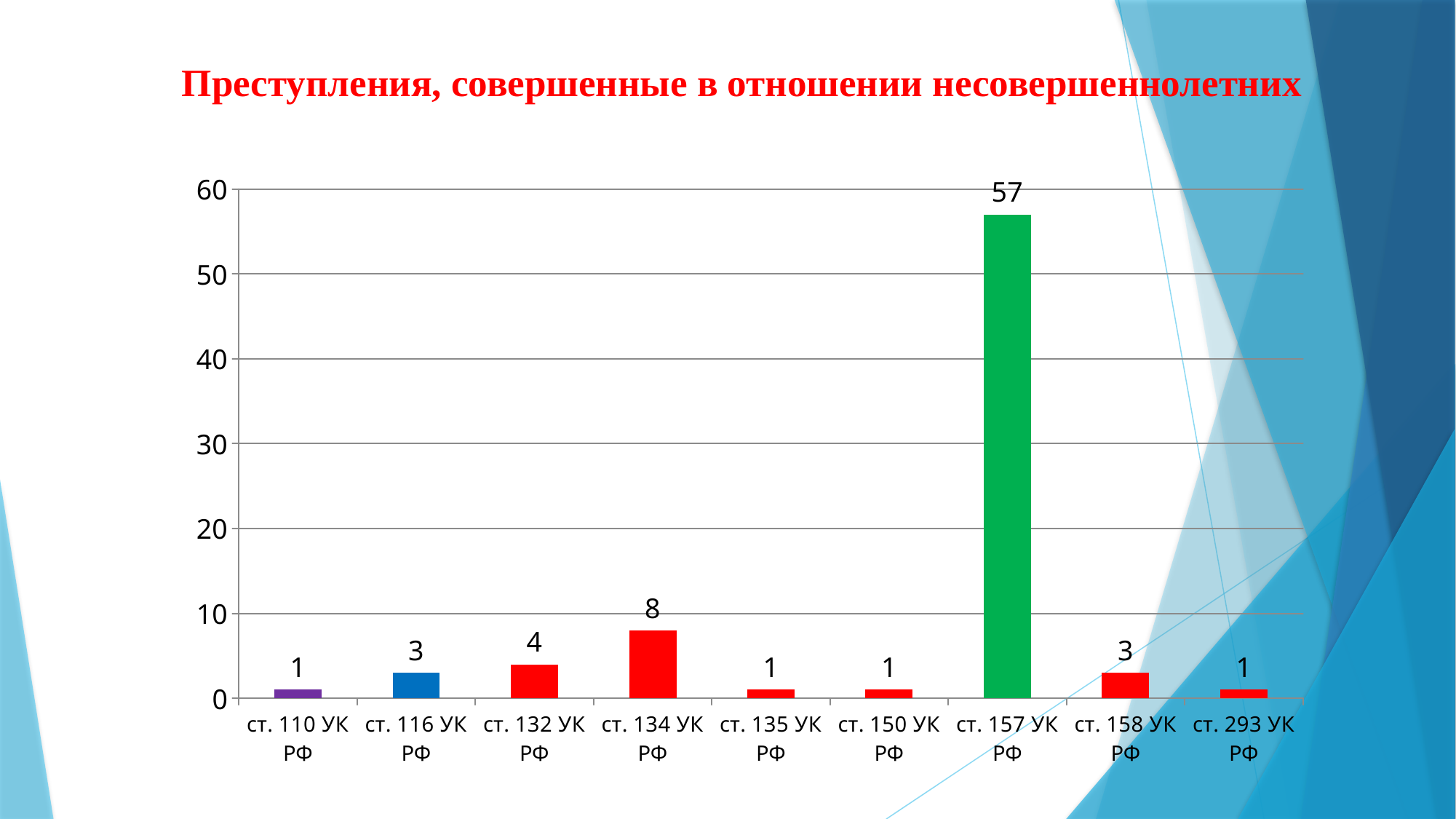
What colour is the bar for ст. 157 УК РФ? green What is the value for ст. 134 УК РФ? 8 What is the difference between the values for ст. 157 УК РФ and ст. 134 УК РФ? 49 Which is larger, the value for ст. 132 УК РФ or the value for ст. 158 УК РФ? ст. 132 УК РФ What is the value for ст. 132 УК РФ? 4 What is the title of the slide? Преступления, совершенные в отношении несовершеннолетних Which category has the highest value? ст. 157 УК РФ What is the value for ст. 157 УК РФ? 57 How many categories are shown on the x axis? 9 What is the value for ст. 116 УК РФ? 3 What kind of chart is shown on the slide? bar chart Is the value for ст. 157 УК РФ greater or less than 50? greater